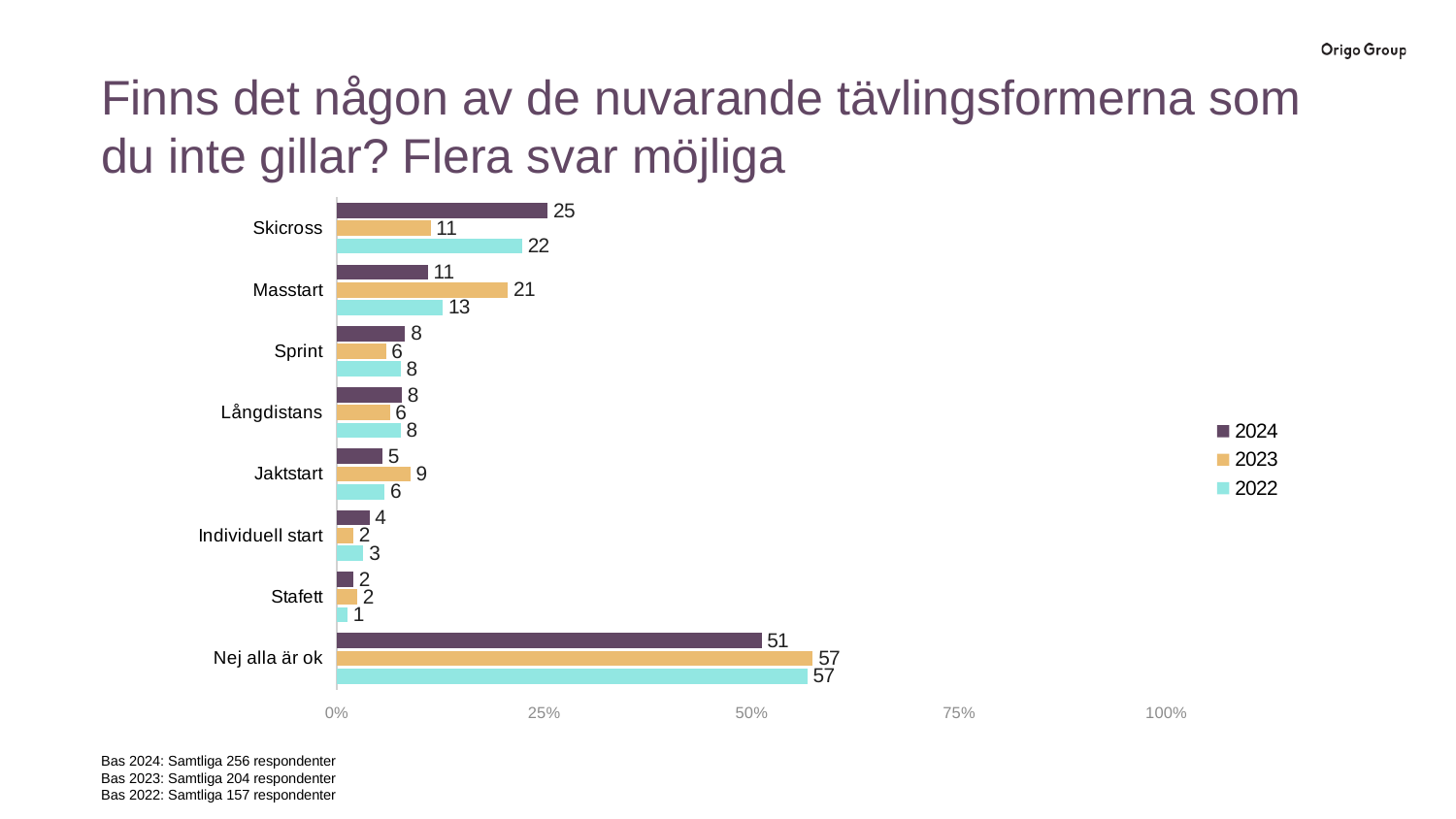
Is the 2024 value for Nej alla är ok greater or less than 50%? greater How many series does the legend list? 3 What is the value for Masstart in the 2023 series? 21 What is the difference between the 2024 and 2023 values for Skicross? 14 Which is larger for Jaktstart: the 2023 value or the 2024 value? 2023 How many categories are shown on the chart? 8 What is the value for Skicross in the 2024 series? 25 What kind of chart is shown on the slide? bar chart Which series is shown in yellow/orange according to the legend? 2023 Which category has the highest value in the 2024 series? Nej alla är ok Which category has the lowest value in the 2022 series? Stafett What is the value for Nej alla är ok in the 2022 series? 57